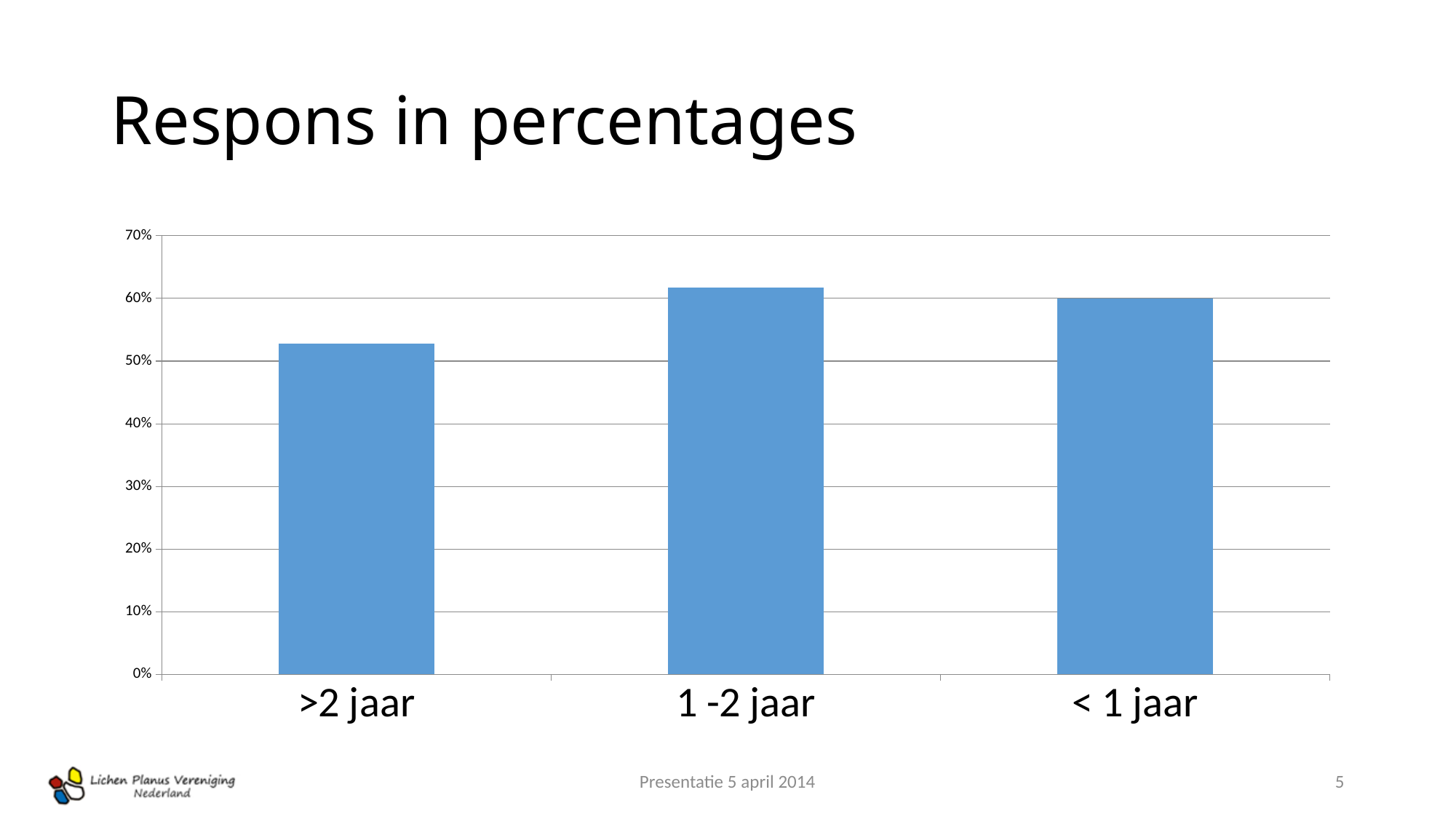
What kind of chart is shown on the slide? bar chart Which is larger, the value for >2 jaar or the value for 1 -2 jaar? 1 -2 jaar Is the value for >2 jaar greater or less than 60%? less Is the value for >2 jaar greater or less than 50%? greater Which category has the lowest bar in the chart? >2 jaar How many categories are shown on the x axis of the chart? 3 What is the highest value shown on the y axis of the chart? 70% Is the value for 1 -2 jaar greater or less than 70%? less What is the title of the slide containing the chart? Respons in percentages Which is larger, the value for >2 jaar or the value for < 1 jaar? < 1 jaar